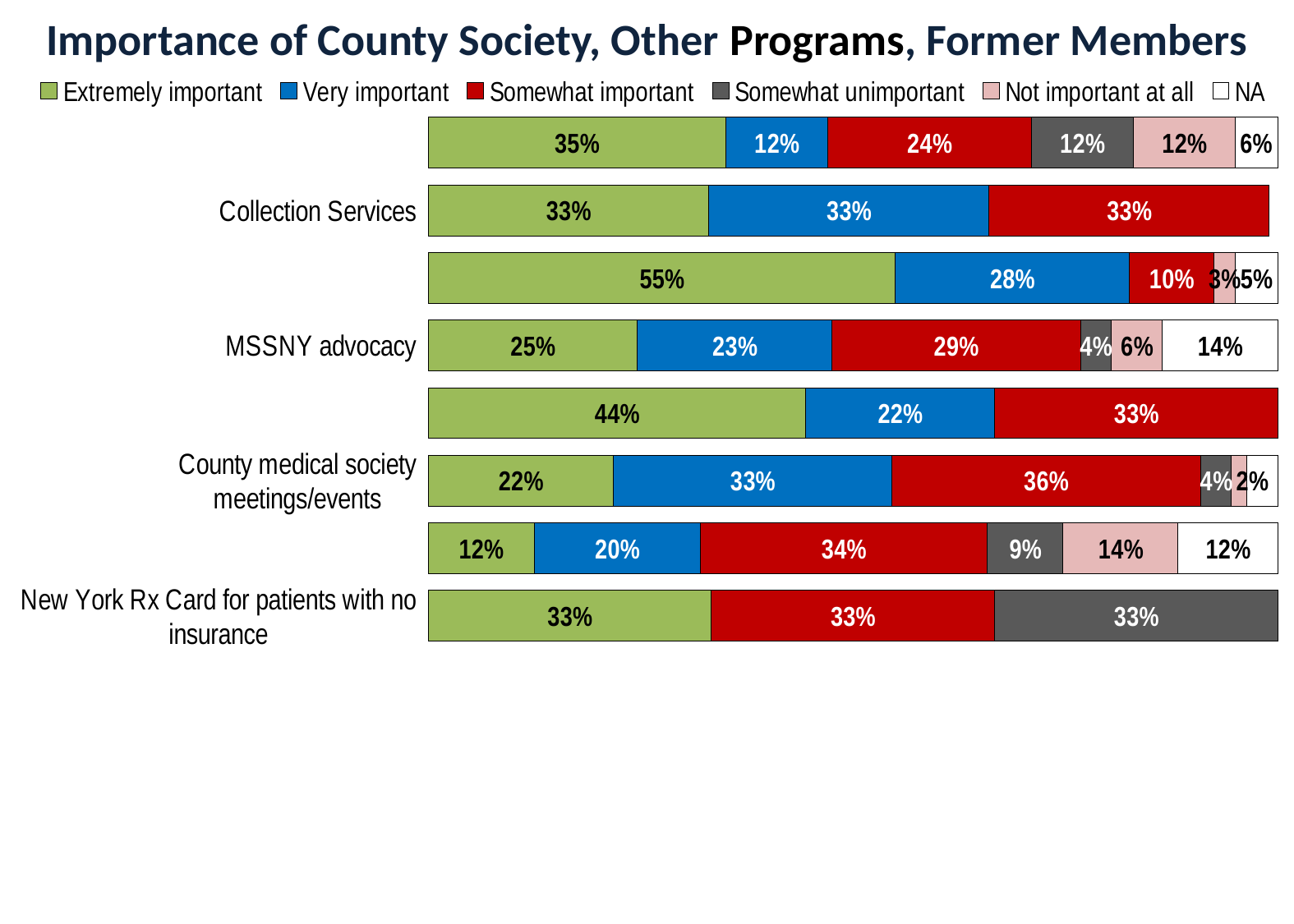
How many series does the legend list? 6 What percentage of former members rated Collection Services as Extremely important? 33% What is the title of the chart? Importance of County Society, Other Programs, Former Members Which response category has the largest share for County medical society meetings/events? Somewhat important What percentage rated the New York Rx Card for patients with no insurance as Somewhat unimportant? 33% What is the NA share for MSSNY advocacy? 14% For MSSNY advocacy, which is larger: the Extremely important share or the Somewhat important share? Somewhat important What kind of chart is shown on the slide? Stacked bar chart What percentage of former members rated MSSNY advocacy as Somewhat important? 29% What percentage rated County medical society meetings/events as Very important? 33% For MSSNY advocacy, what is the difference between the NA share and the Not important at all share? 8% What is the difference between the Somewhat important and Extremely important shares for County medical society meetings/events? 14%